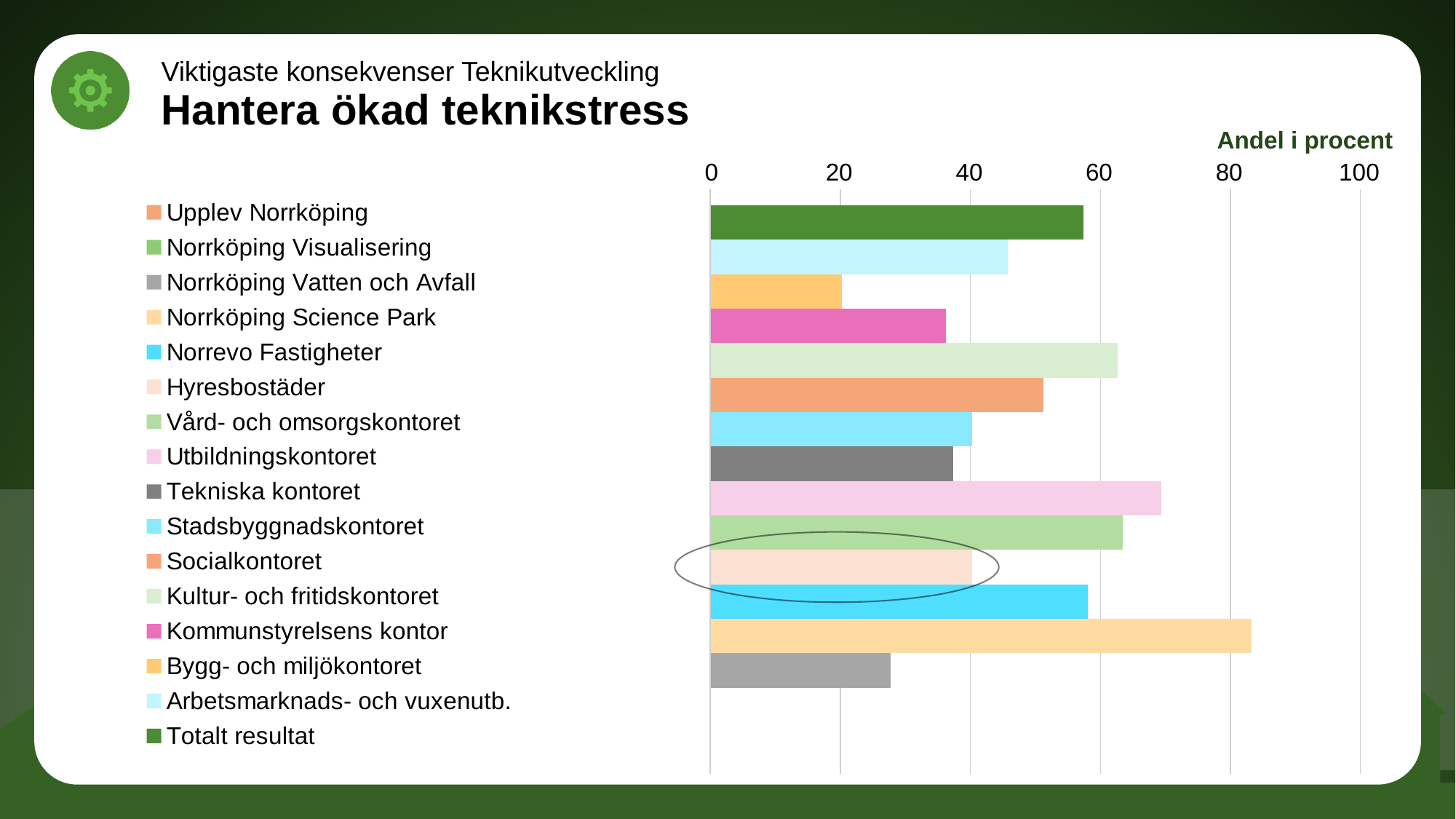
Which is larger, the value for Norrköping Science Park or the value for Norrköping Vatten och Avfall? Norrköping Science Park What kind of chart is shown on the slide? bar chart What label is shown above the horizontal axis of the chart? Andel i procent Is the value for Kommunstyrelsens kontor greater or less than 40? less Is the value for Utbildningskontoret greater or less than 60? greater Which category has the longest bar? Norrköping Science Park Is the value for Norrköping Science Park greater or less than 80? greater Which is larger, the value for Utbildningskontoret or the value for Socialkontoret? Utbildningskontoret How many entries does the legend list? 16